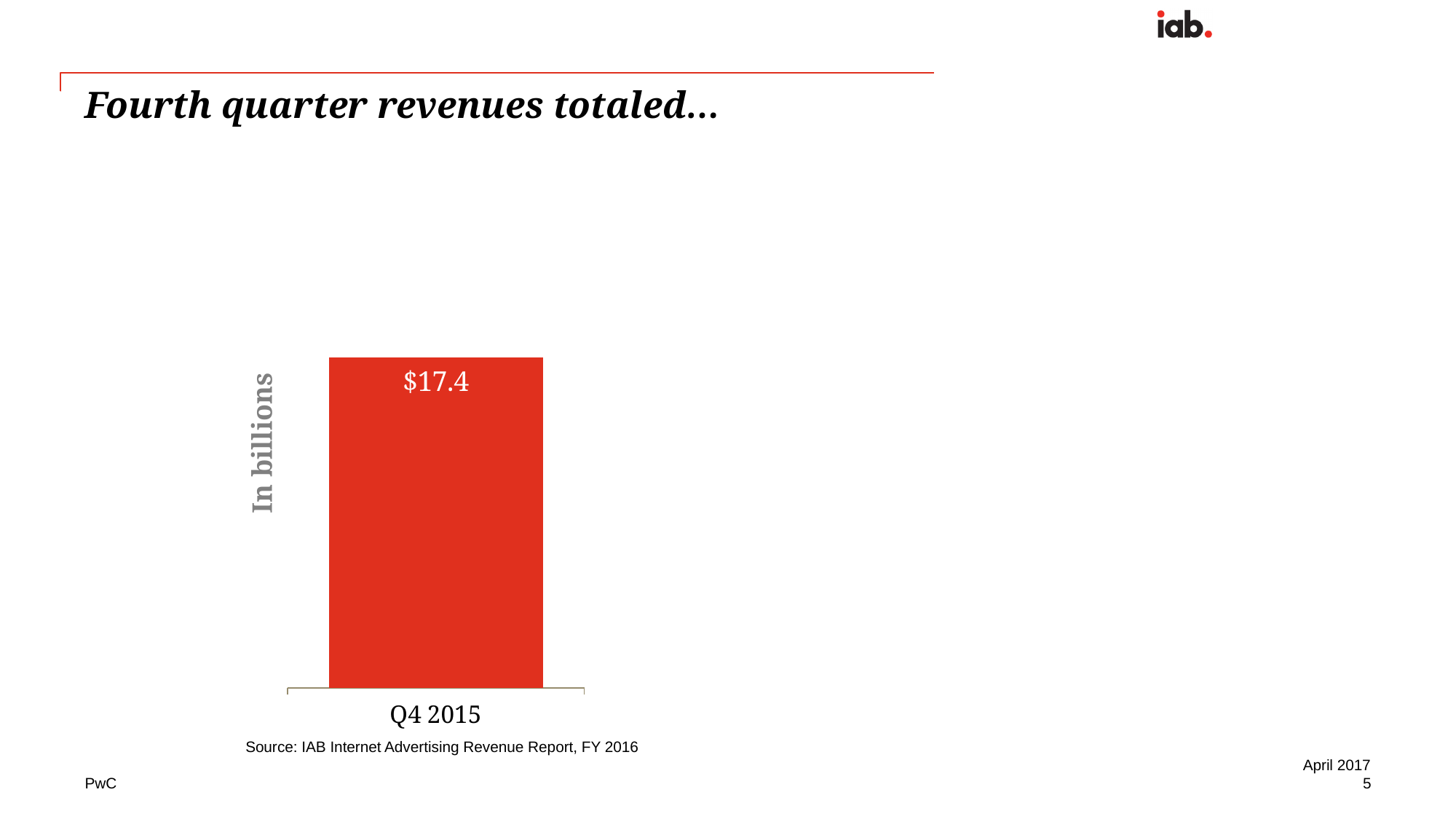
What is the y-axis label of the chart? In billions What is the label of the category on the x axis? Q4 2015 How many bars are plotted in the chart? 1 What is the value shown for Q4 2015? $17.4 What kind of chart is shown on the slide? bar chart